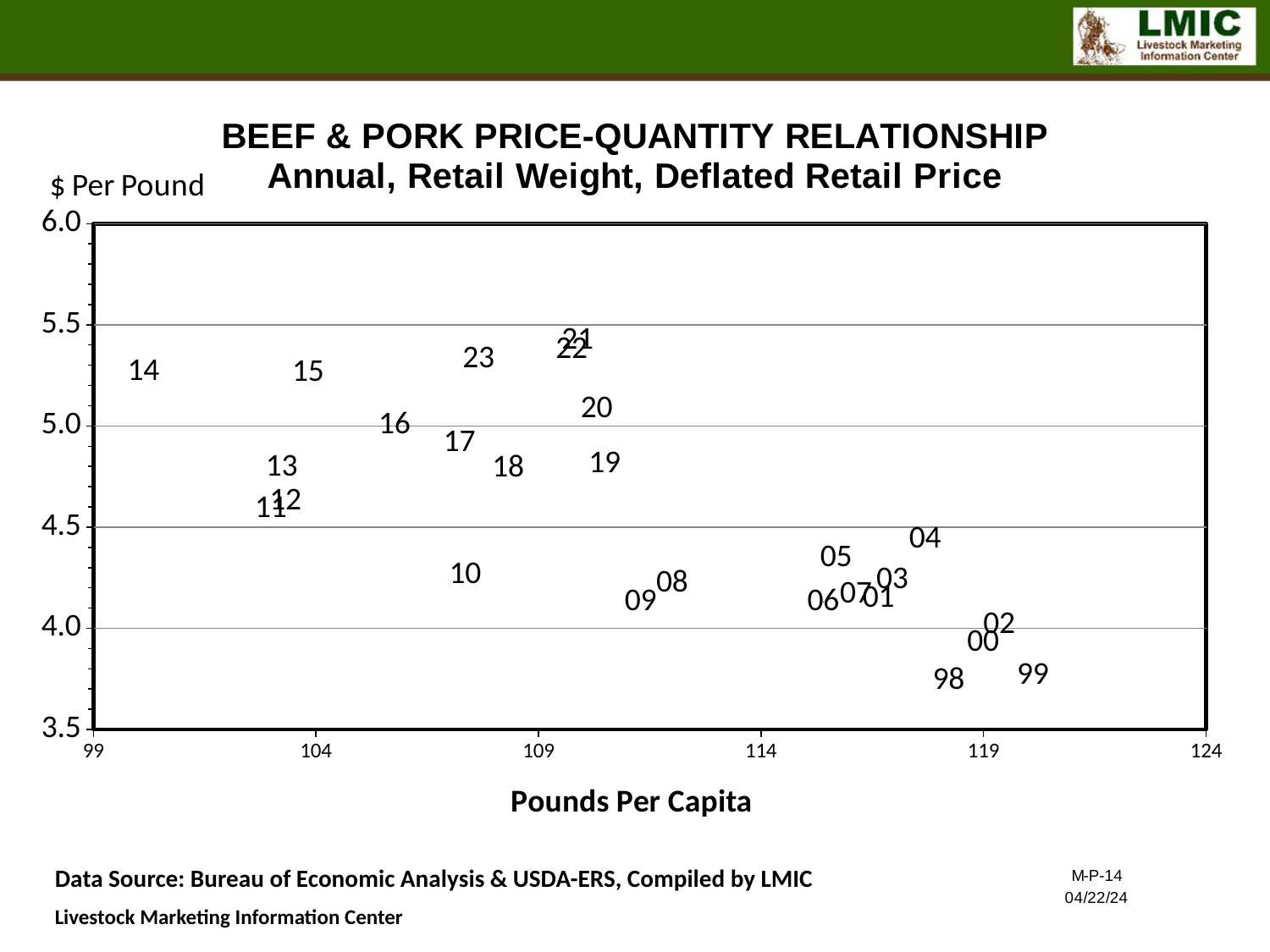
Which point has the higher price, the one labeled 14 or the one labeled 98? 14 Is the price value for the point labeled 10 greater or less than 4.5? less What is the label of the horizontal axis? Pounds Per Capita Is the price value for the point labeled 19 greater or less than 5.0? less Is the price value for the point labeled 98 greater or less than 4.0? less As pounds per capita increases along the x axis, do the prices generally rise or fall? fall What kind of chart is shown on the slide? scatter chart What is the title of the chart? BEEF & PORK PRICE-QUANTITY RELATIONSHIP Annual, Retail Weight, Deflated Retail Price Which point has the higher price, the one labeled 23 or the one labeled 09? 23